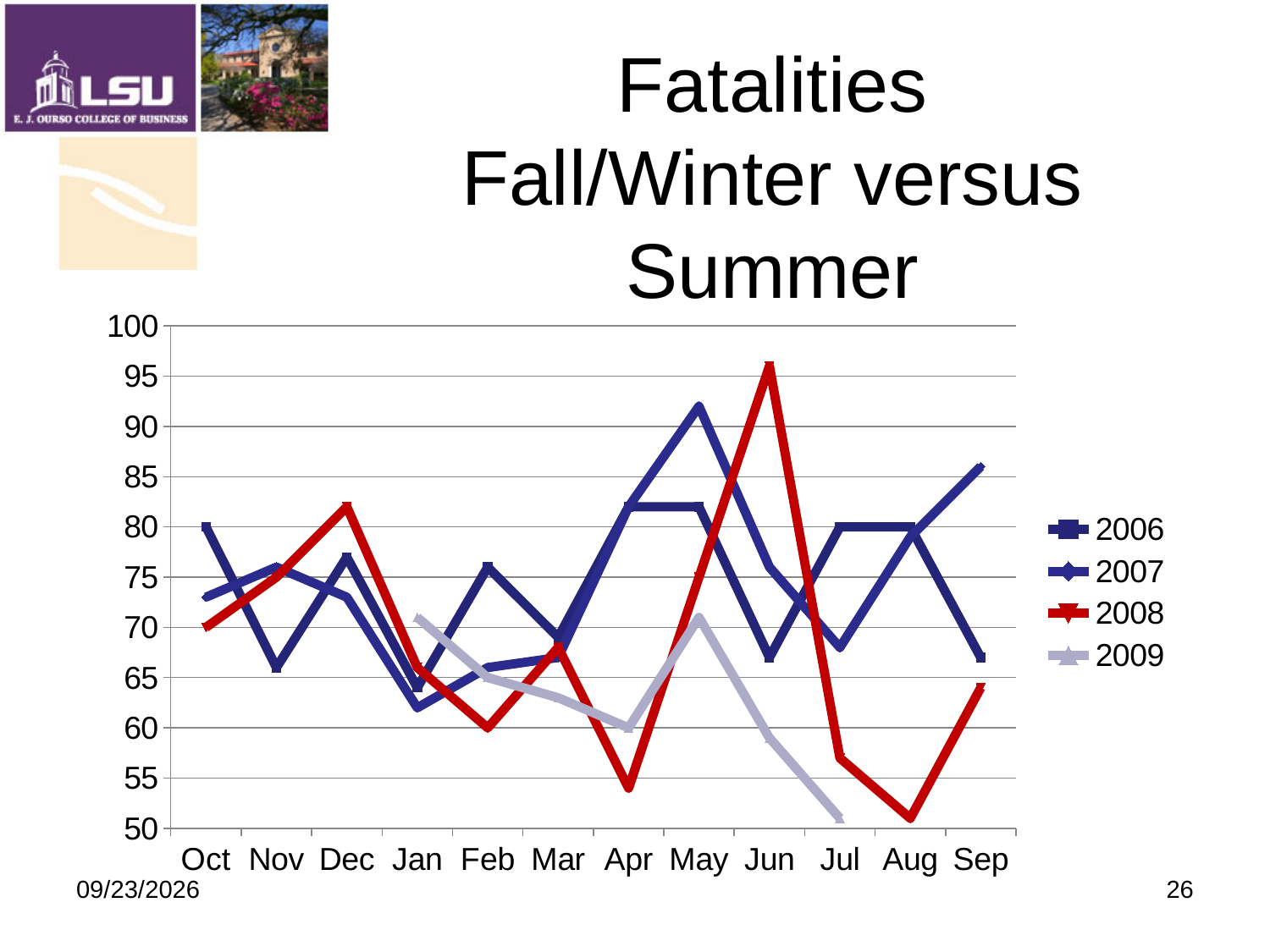
Is the value for 2009 in Jul greater or less than 55? less How many series does the legend list? 4 In which month does the 2008 series reach its highest value? Jun In Jun, which series has the larger value, 2008 or 2006? 2008 Does the 2009 series rise or fall from May to Jul? fall Is the value for 2008 in Jun greater or less than 90? greater Which series is drawn in red? 2008 Is the value for 2008 in Aug greater or less than 55? less What kind of chart is shown on the slide? line chart In which month does the 2008 series reach its lowest value? Aug In which month does the 2007 series reach its highest value? May How many months are shown along the x axis? 12